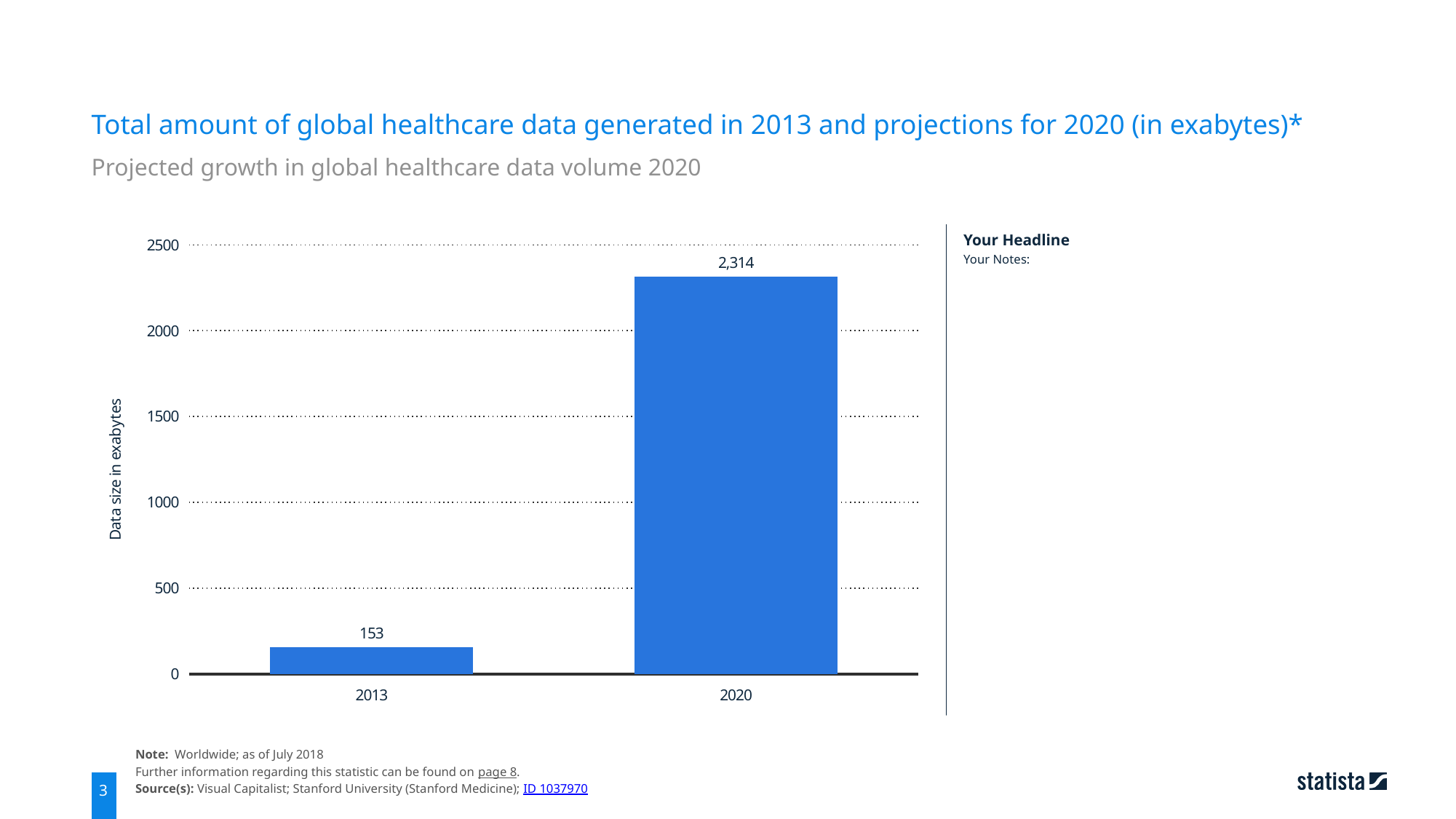
What kind of chart is shown? bar chart What is the difference between the values for 2020 and 2013? 2,161 Which year has the lowest value? 2013 Is the value for 2020 greater or less than 2000? greater Which year has the highest value? 2020 What is the value for 2013? 153 Is the value for 2013 greater or less than 500? less What is the projected value for 2020? 2,314 How many categories are shown on the x axis? 2 What is the label of the y axis? Data size in exabytes Do the values rise or fall from 2013 to 2020? rise Which is larger, the value for 2013 or the value for 2020? 2020